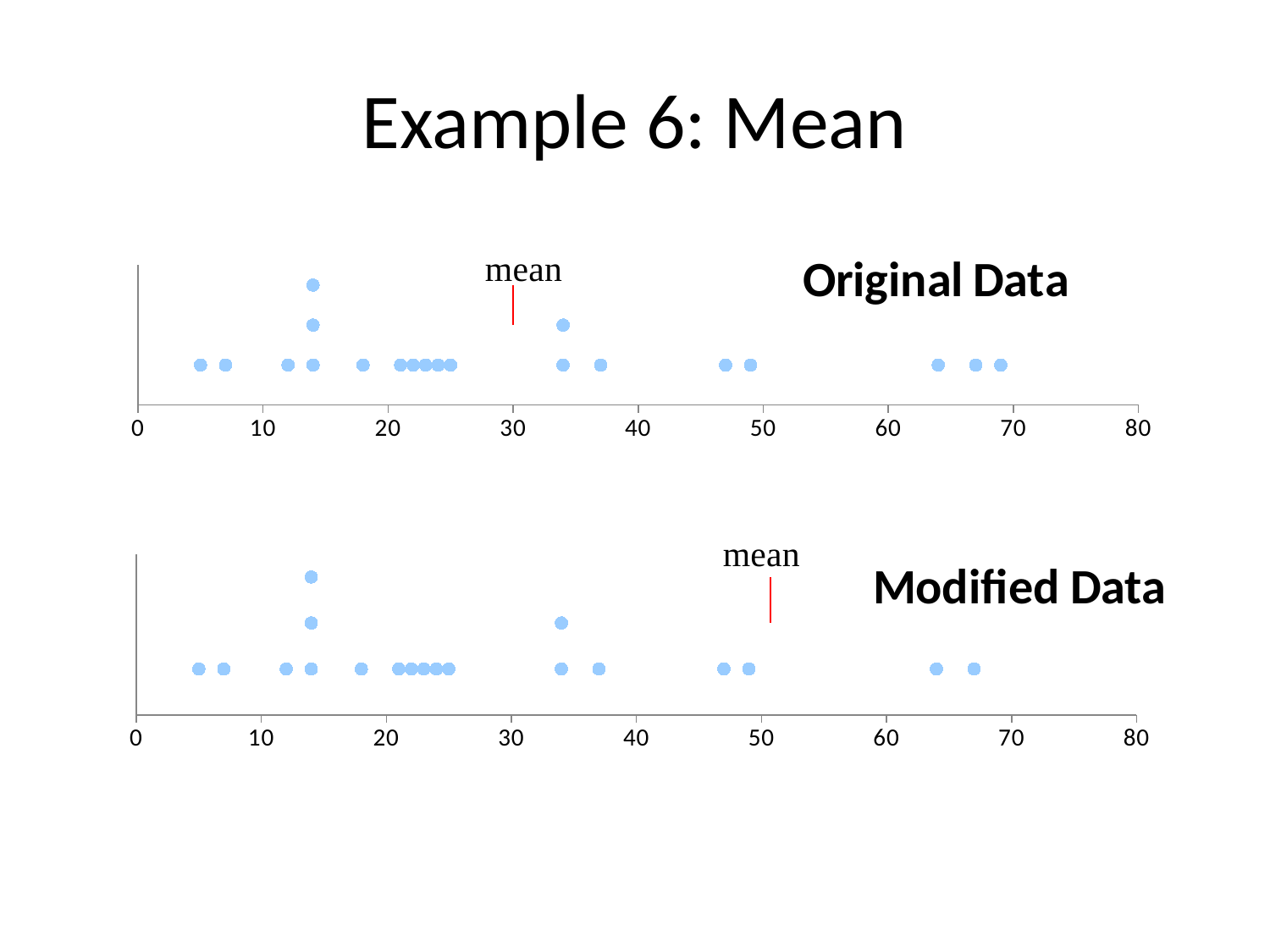
In the Original Data chart, is the smallest data value greater or less than 10? less What does the red vertical line on each chart mark? the mean What kind of chart is used for the Original Data and Modified Data displays? dot plot Which chart shows the larger mean, Original Data or Modified Data? Modified Data What are the titles of the two charts on the slide? Original Data and Modified Data How many dots are plotted in the Modified Data chart? 19 In the Original Data chart, is the largest data value greater or less than 60? greater In the Modified Data chart, is the mean greater or less than 40? greater What is the highest value shown on the x axis of the Original Data chart? 80 How many dots are plotted in the Original Data chart? 20